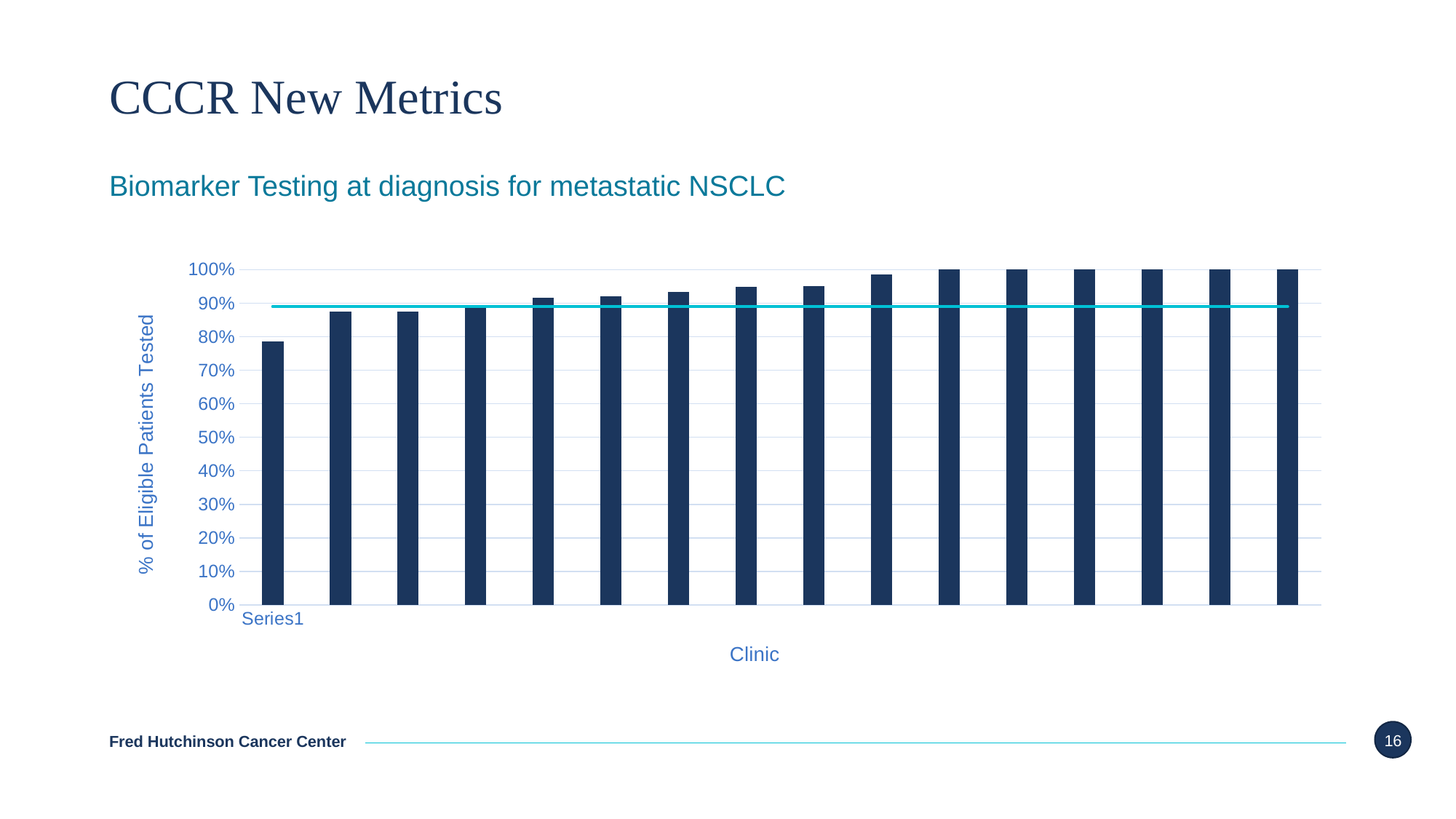
Is the value for the leftmost bar (Series1) greater or less than 80%? less Which is larger, the value of the leftmost bar or the value of the rightmost bar? The rightmost bar Is the value for the rightmost bar greater or less than 90%? greater Is the value for the second bar from the left greater or less than 80%? greater What is the title of the vertical axis of the chart? % of Eligible Patients Tested What is the title of the horizontal axis of the chart? Clinic Which bar has the lowest value in the chart? The first (leftmost) bar, labelled Series1 How many bars are plotted in the chart? 16 Do the bar values rise or fall from left to right across the chart? Rise What kind of chart is shown on the slide? Combination bar and line chart